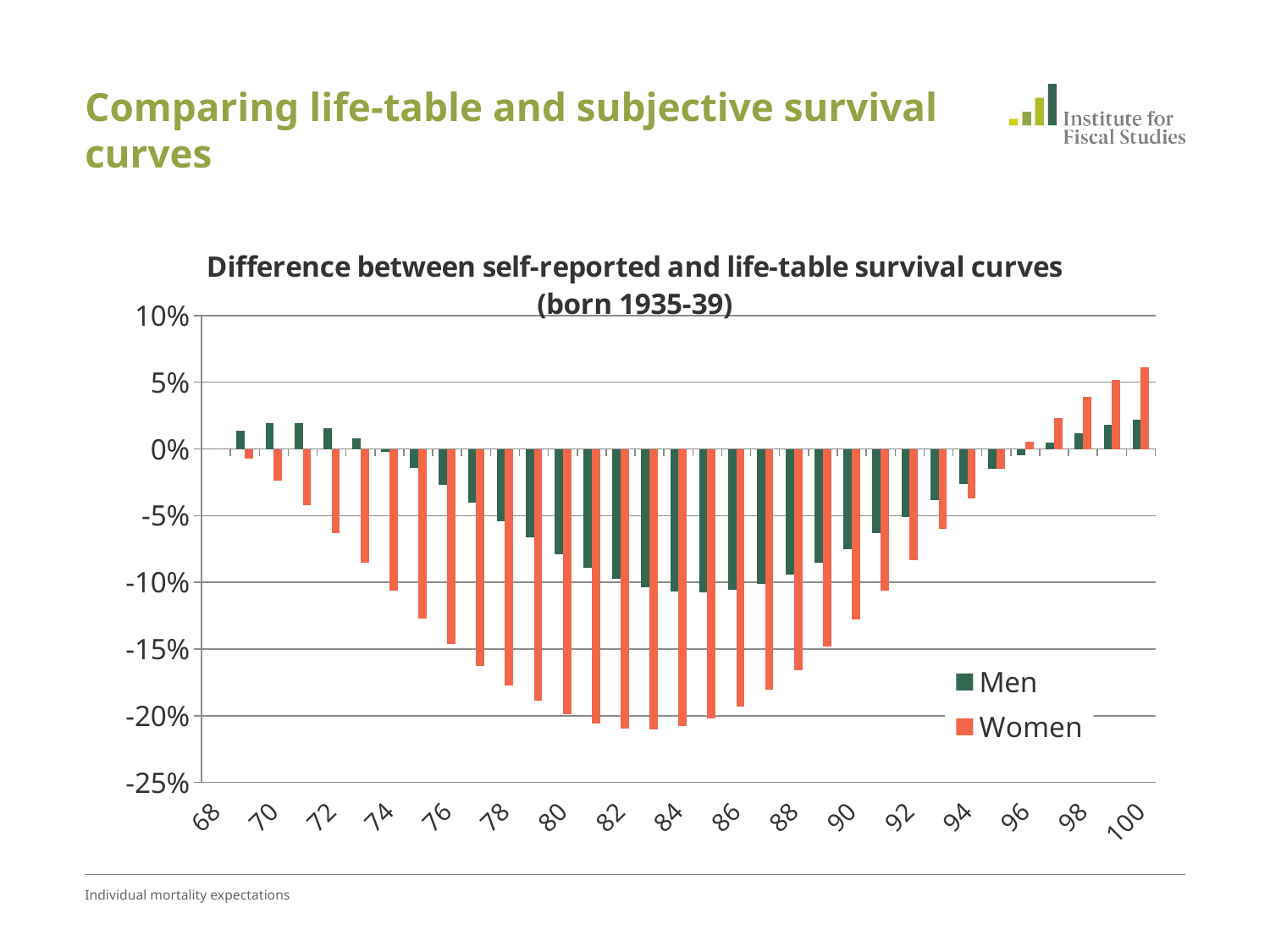
At age 100, which series has the larger value, Men or Women? Women Do the Women values rise or fall along the x axis from age 90 to age 100? rise What kind of chart is shown on the slide? bar chart Is the value for Women at age 78 greater or less than -15%? less At age 84, which series has the larger value, Men or Women? Men What is the title of the chart? Difference between self-reported and life-table survival curves (born 1935-39) Is the value for Women at age 82 greater or less than -20%? less How many series does the legend list? 2 Which colour represents the Women series in the chart? orange Is the value for Men at age 80 greater or less than -10%? greater